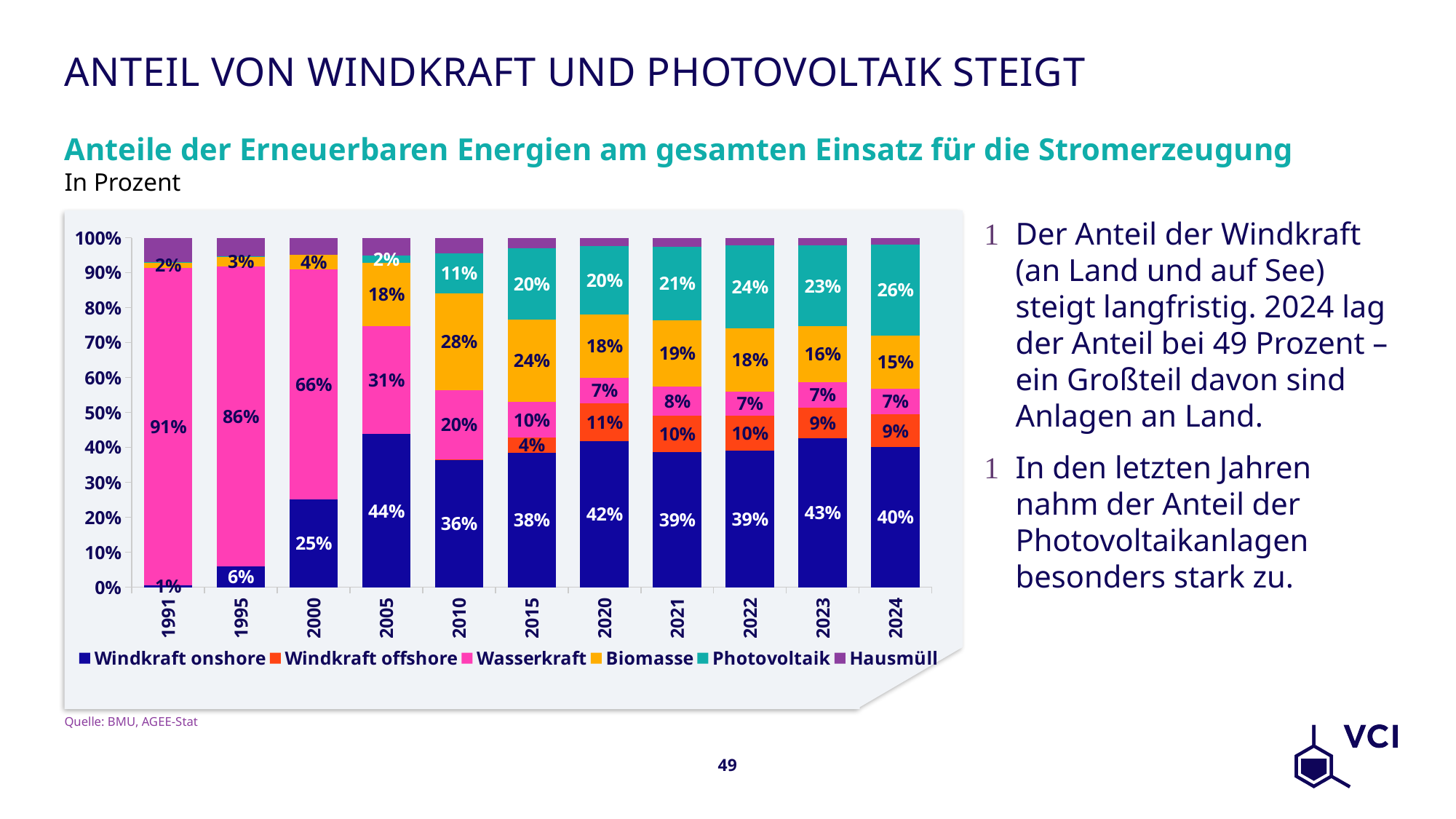
What is the share of Windkraft offshore in 2020? 11% What kind of chart is shown on the slide? Stacked bar chart Does the share of Wasserkraft rise or fall from 1991 to 2024? Fall Which is larger in 2015: the share of Biomasse or the share of Photovoltaik? Biomasse What is the share of Photovoltaik in 2024? 26% What is the difference between the Photovoltaik share in 2024 and in 2010? 15 percentage points How many series does the legend list? 6 In which year is the share of Windkraft onshore highest? 2005 What is the share of Biomasse in 2010? 28% What is the share of Wasserkraft in 1991? 91% How many years are shown on the x axis? 11